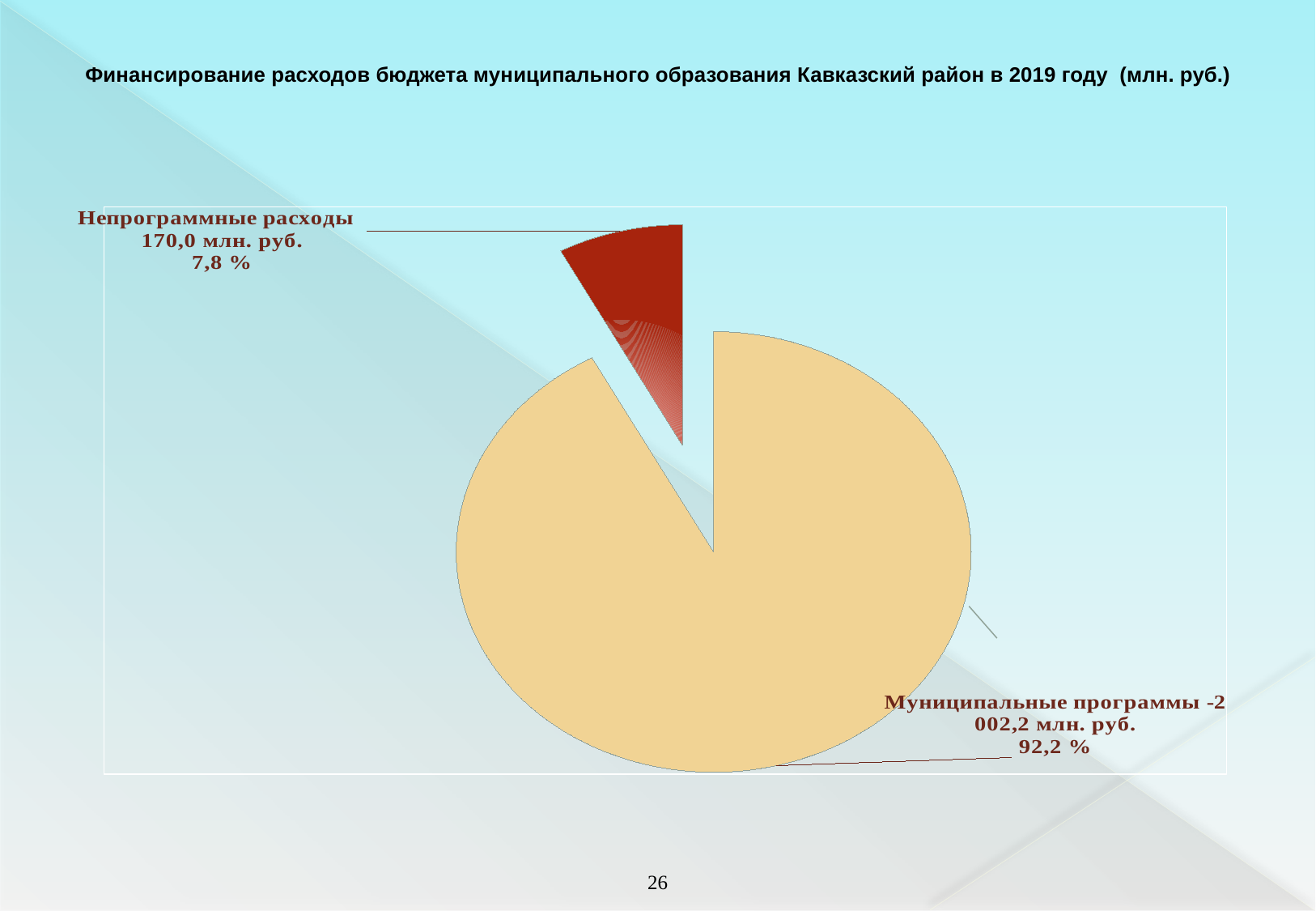
What is the title of the chart? Финансирование расходов бюджета муниципального образования Кавказский район в 2019 году (млн. руб.) What share of the pie does Непрограммные расходы represent? 7,8 % Which category has the largest slice of the pie? Муниципальные программы What kind of chart is shown on the slide? Pie chart What share of the pie does Муниципальные программы represent? 92,2 % What is the value for Непрограммные расходы? 170,0 млн. руб. What colour is the slice for Непрограммные расходы? Dark red What is the value for Муниципальные программы? 2 002,2 млн. руб. How many slices does the pie chart have? 2 Which category has the smallest slice of the pie? Непрограммные расходы Which is larger: Муниципальные программы or Непрограммные расходы? Муниципальные программы What is the difference in млн. руб. between Муниципальные программы and Непрограммные расходы? 1 832,2 млн. руб.